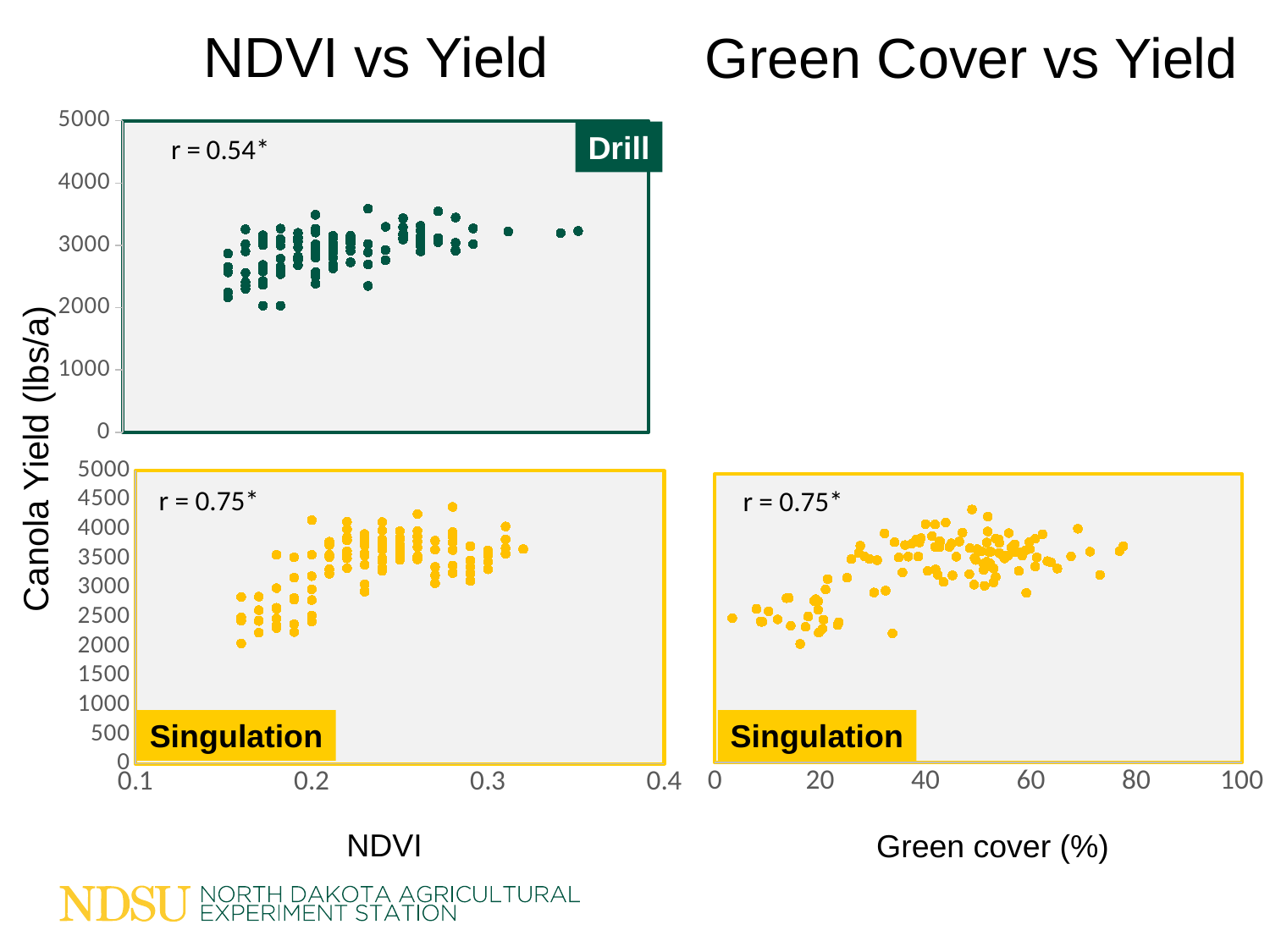
In the NDVI vs Yield Drill chart, does canola yield generally rise or fall as NDVI increases? rise In the NDVI vs Yield Drill chart, what is the correlation coefficient r shown? r = 0.54* In the NDVI vs Yield Singulation chart, what is the correlation coefficient r shown? r = 0.75* In the Green Cover vs Yield Singulation chart, what is the correlation coefficient r shown? r = 0.75* In the Green Cover vs Yield chart, does canola yield generally rise or fall as green cover increases? rise Which NDVI vs Yield chart has the higher correlation coefficient, Drill or Singulation? Singulation What kind of chart is the NDVI vs Yield Drill chart? scatter chart What is the label of the shared y axis on the slide? Canola Yield (lbs/a) How many scatter charts are shown on the slide? 3 What is the x-axis label of the Green Cover vs Yield chart? Green cover (%) In the NDVI vs Yield Drill chart, is the highest yield point greater or less than 4000? less In the Green Cover vs Yield chart, is the lowest yield point greater or less than 2500? less